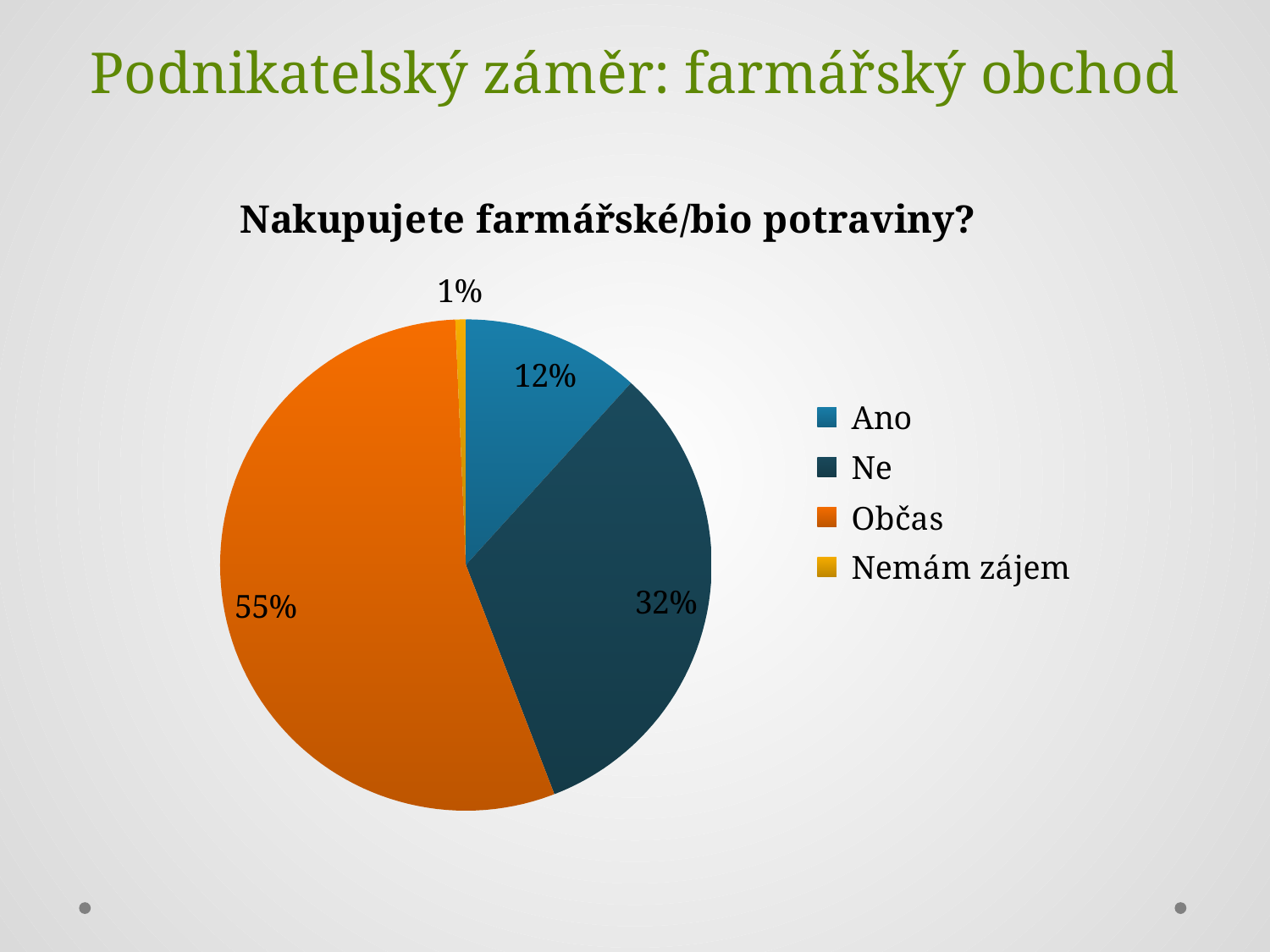
What is the difference in percentage points between the 'Občas' and 'Ne' slices? 23 What colour is the 'Občas' slice? orange What share of the pie does the 'Ne' slice represent? 32% How many categories does the legend list? 4 What is the chart's title? Nakupujete farmářské/bio potraviny? What kind of chart is shown on the slide? pie chart What share of the pie does the 'Ano' slice represent? 12% What share of the pie does the 'Nemám zájem' slice represent? 1% Which category has the smallest slice of the pie? Nemám zájem Which slice is larger, 'Ano' or 'Ne'? Ne Which category has the largest slice of the pie? Občas